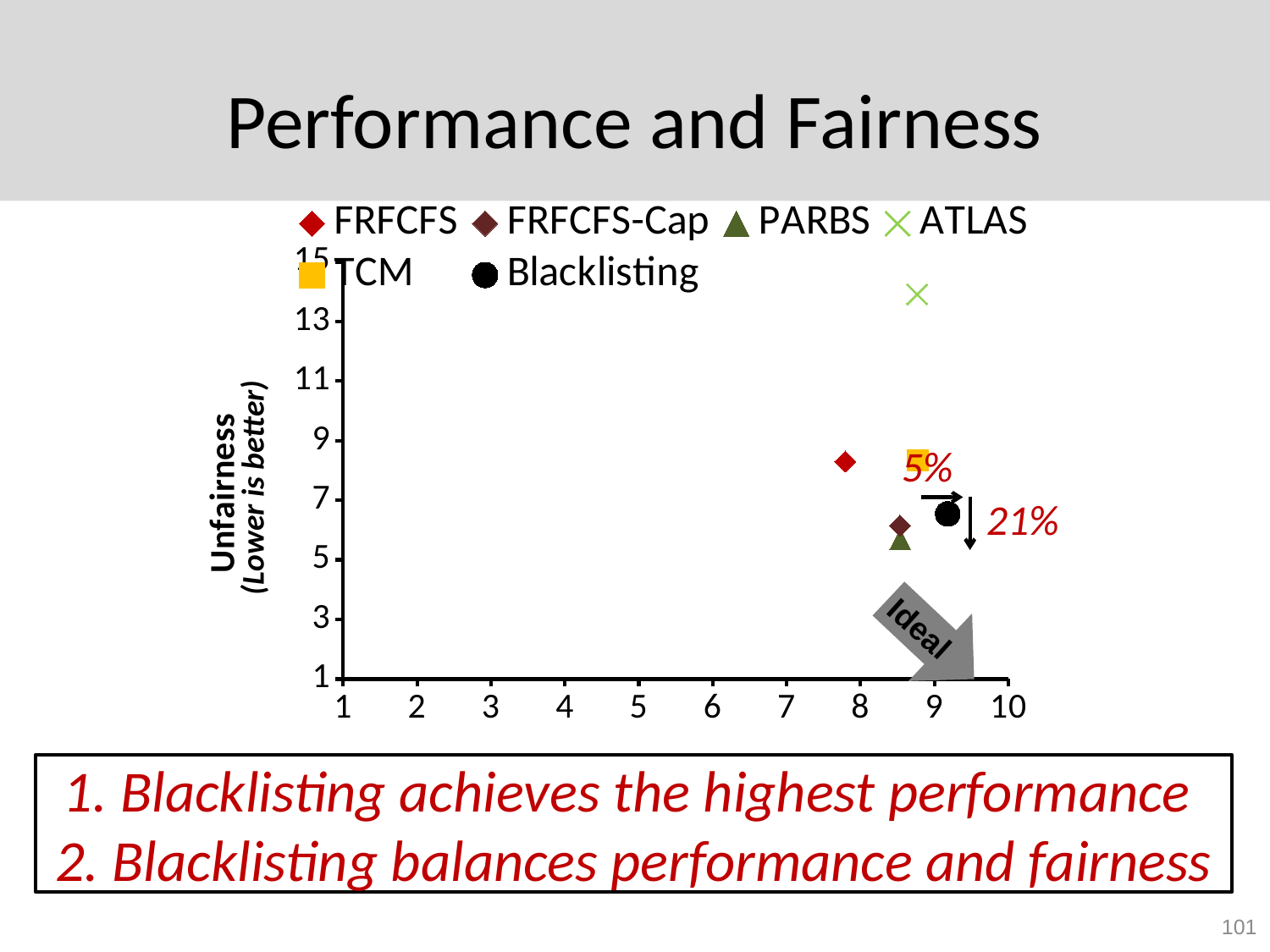
Is the unfairness value for TCM greater or less than 7? greater Which series is plotted further to the right on the x axis, FRFCFS or Blacklisting? Blacklisting Which has the higher unfairness value, ATLAS or FRFCFS? ATLAS Which series has the highest unfairness value? ATLAS What kind of chart is shown on the slide? scatter chart What marker shape and colour represents Blacklisting in the legend? black circle How many series does the legend list? 6 What is the label of the y axis? Unfairness (Lower is better) Is the unfairness value for FRFCFS greater or less than 9? less How many data points are plotted on the chart? 6 Is the unfairness value for ATLAS greater or less than 13? greater